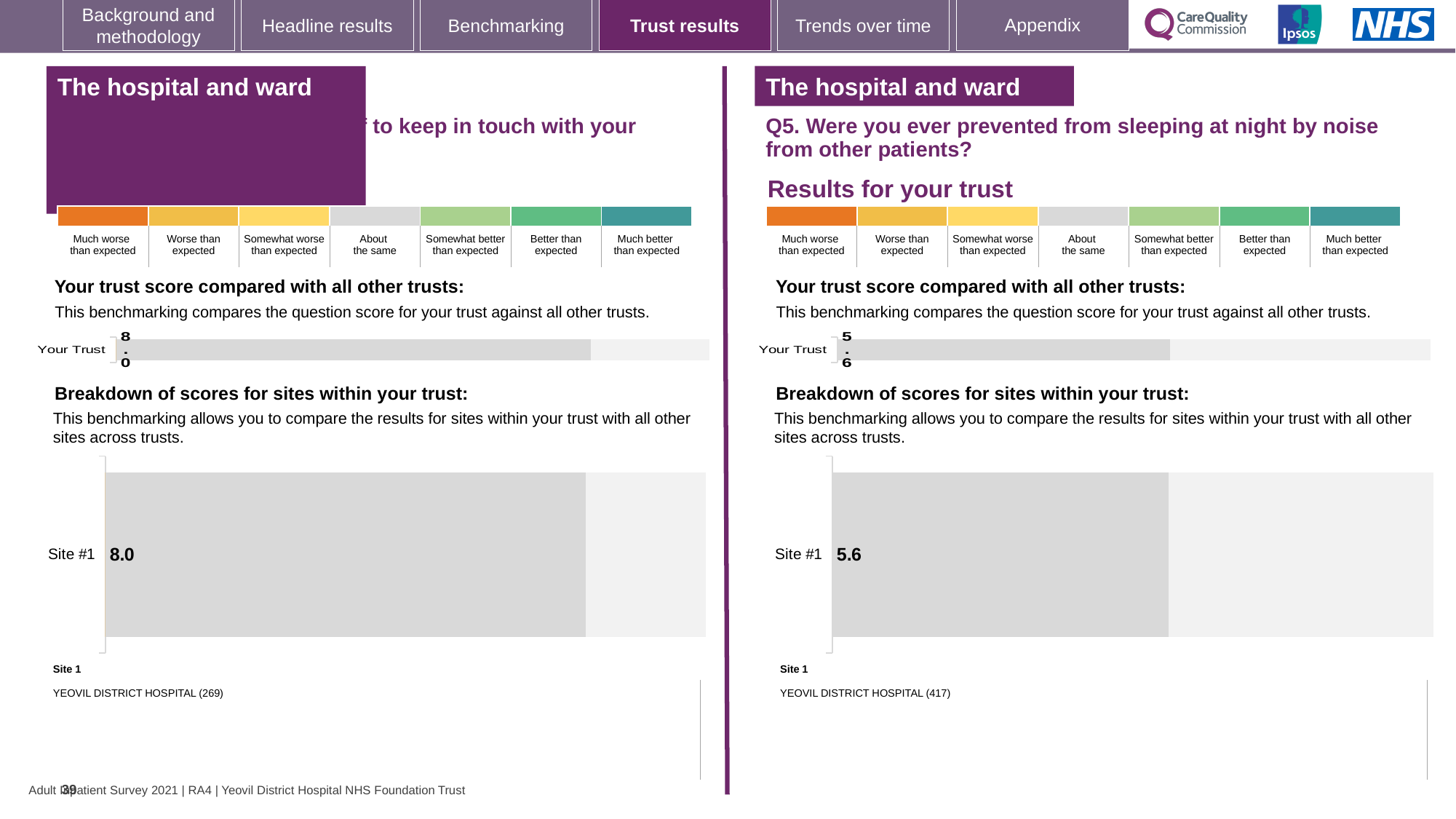
What is the difference between the Site #1 score on the left-hand chart (8.0) and the Site #1 score on the right-hand chart (5.6)? 2.4 How many sites are shown in the site breakdown chart on the right-hand side (Q5)? 1 On the right-hand chart (Q5), what is the score shown for Your Trust? 5.6 On the left-hand site breakdown chart, what is the score for Site #1? 8.0 How many bars are plotted in the Your Trust chart on the left-hand side? 1 On the right-hand site breakdown chart (Q5), what is the score for Site #1? 5.6 On the right-hand side (Q5), which hospital is listed as Site 1? YEOVIL DISTRICT HOSPITAL (417) How many rating categories are shown in the colour scale above the right-hand chart (Q5)? 7 What kind of chart is used to show the Your Trust score on the right-hand side (Q5)? bar chart Which is larger, the Your Trust score on the left-hand chart or the Your Trust score on the right-hand chart (Q5)? the left-hand chart On the left-hand chart, what is the score shown for Your Trust? 8.0